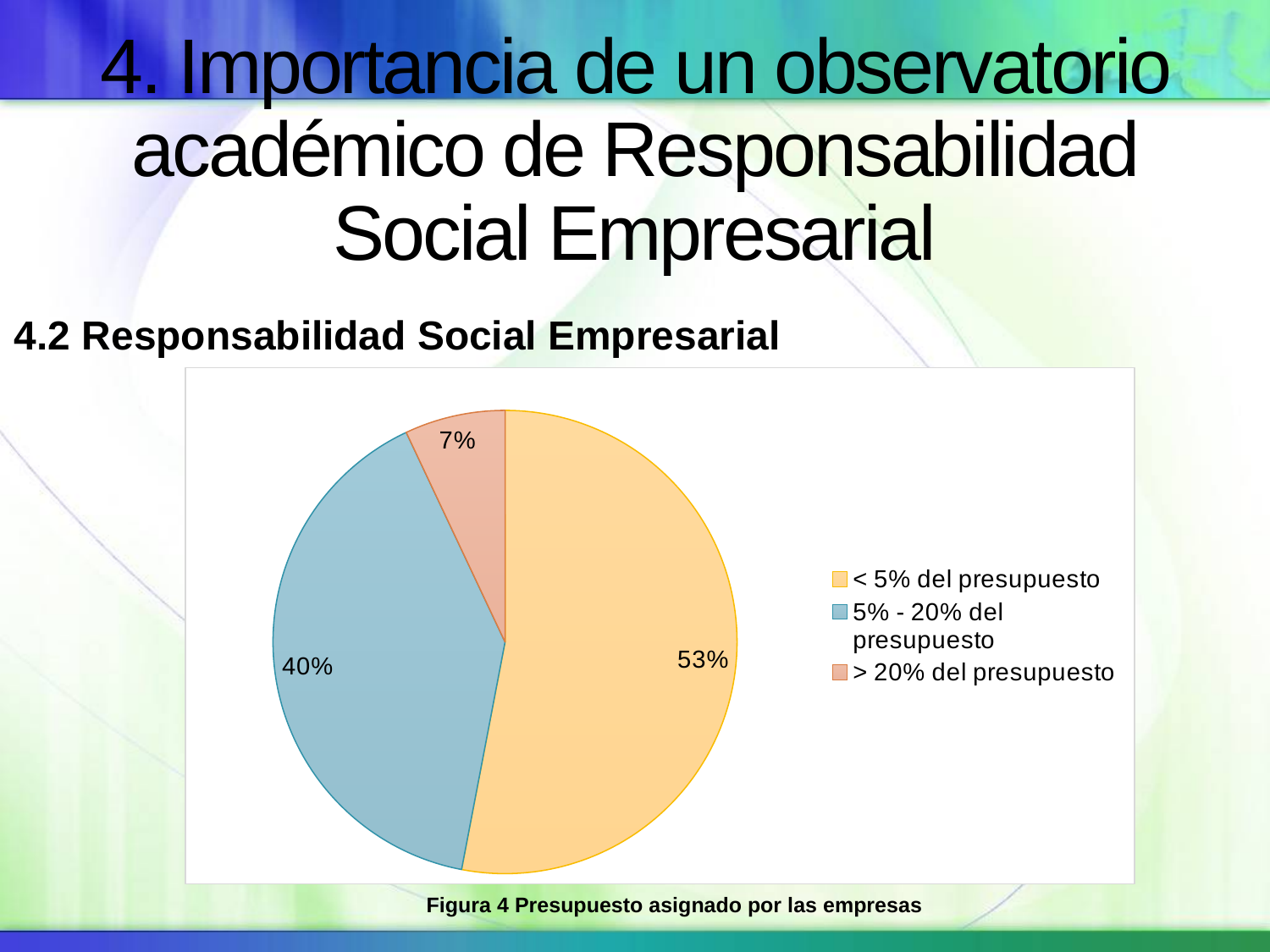
What share of the pie does the "< 5% del presupuesto" slice represent? 53% Which is larger: the "5% - 20% del presupuesto" slice or the "> 20% del presupuesto" slice? 5% - 20% del presupuesto What share of the pie does the "5% - 20% del presupuesto" slice represent? 40% What is the caption of the figure below the chart? Figura 4 Presupuesto asignado por las empresas What is the difference in percentage points between the "< 5% del presupuesto" slice and the "5% - 20% del presupuesto" slice? 13 What colour is the "5% - 20% del presupuesto" slice in the pie chart? blue What share of the pie does the "> 20% del presupuesto" slice represent? 7% Which category has the smallest slice of the pie? > 20% del presupuesto What is the difference in percentage points between the "5% - 20% del presupuesto" slice and the "> 20% del presupuesto" slice? 33 How many slices does the pie chart have? 3 What kind of chart is shown on the slide? pie chart Which category has the largest slice of the pie? < 5% del presupuesto